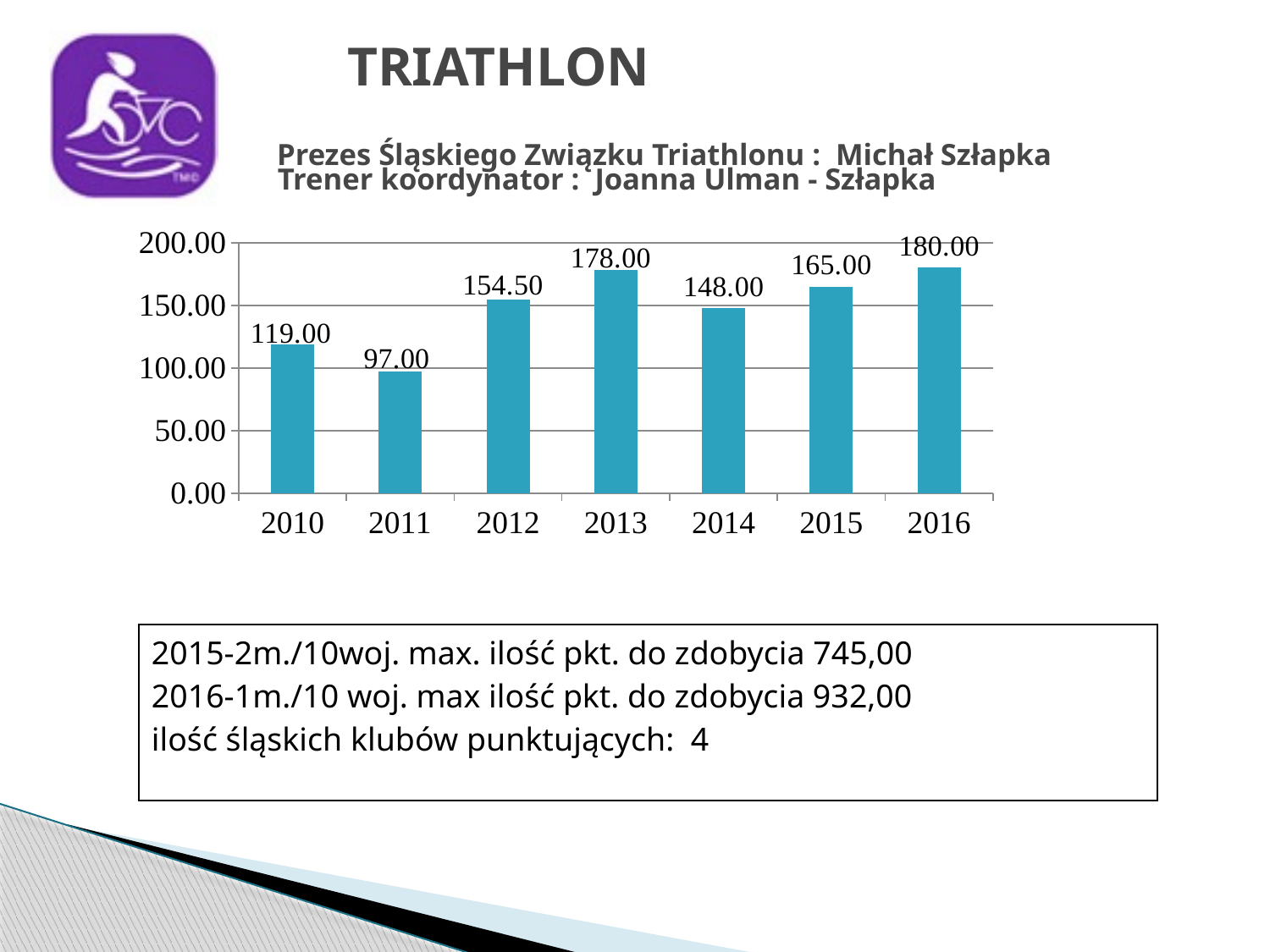
What kind of chart is shown on the slide? bar chart How many years are shown on the x axis? 7 Which year has the highest value? 2016 Does the value rise or fall from 2013 to 2014? fall What is the difference between the values for 2016 and 2015? 15.00 What is the difference between the values for 2012 and 2011? 57.50 Which year has the lowest value? 2011 What is the value for 2011? 97.00 Which is larger, the value for 2013 or the value for 2014? 2013 What is the value for 2013? 178.00 Is the value for 2010 greater or less than 100.00? greater What is the value for 2016? 180.00